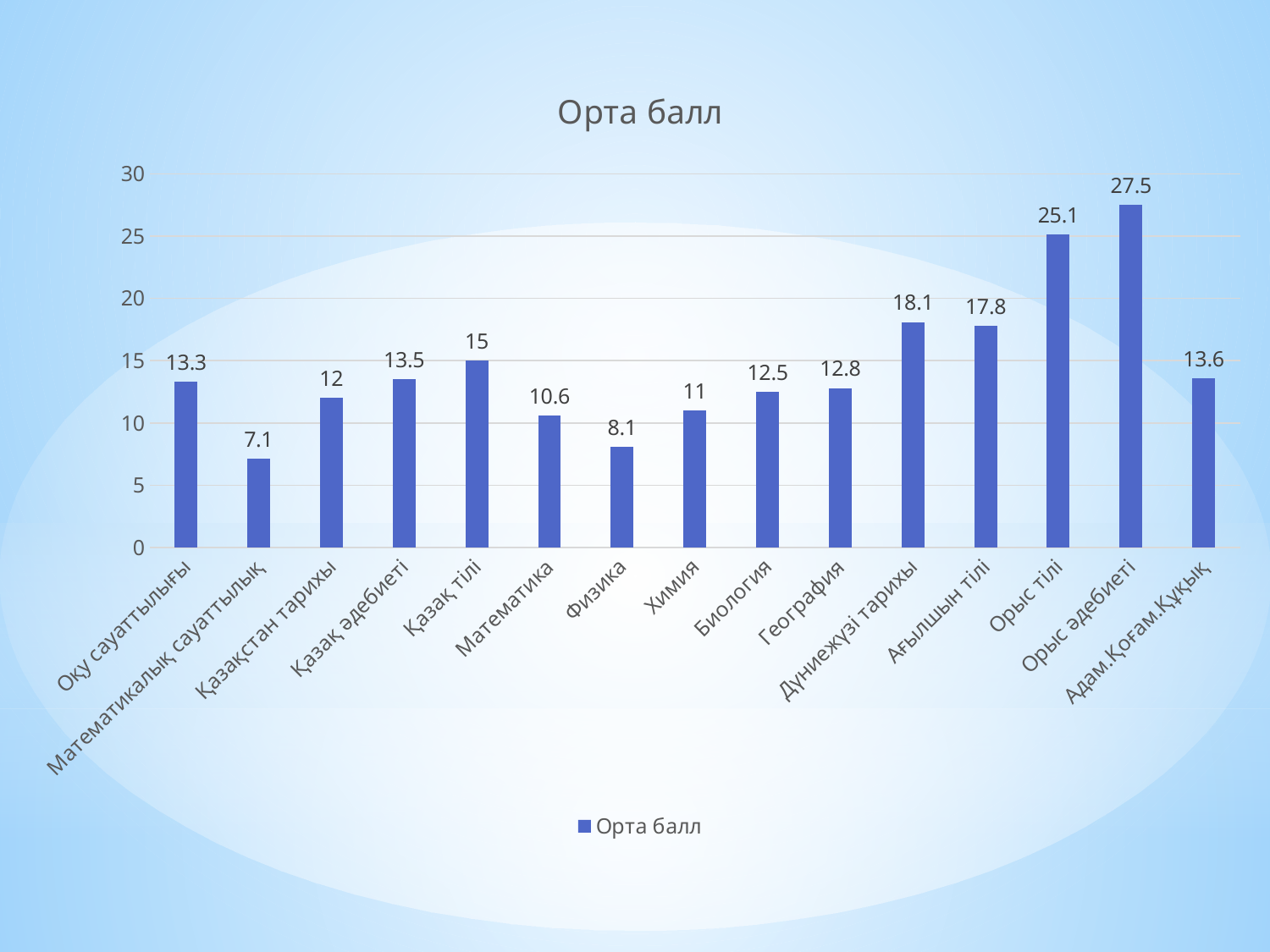
How many categories are shown on the x axis? 15 What is the difference between the values for Орыс тілі and Физика? 17 What is the value for Орыс әдебиеті? 27.5 What is the value for Дүниежүзі тарихы? 18.1 Is the value for Ағылшын тілі greater or less than 15? greater What is the value for Математика? 10.6 What is the title of the chart? Орта балл Which is larger, the value for Қазақ тілі or the value for Химия? Қазақ тілі Which category has the highest value? Орыс әдебиеті What kind of chart is shown on the slide? bar chart How many series does the legend list? 1 Which category has the lowest value? Математикалық сауаттылық